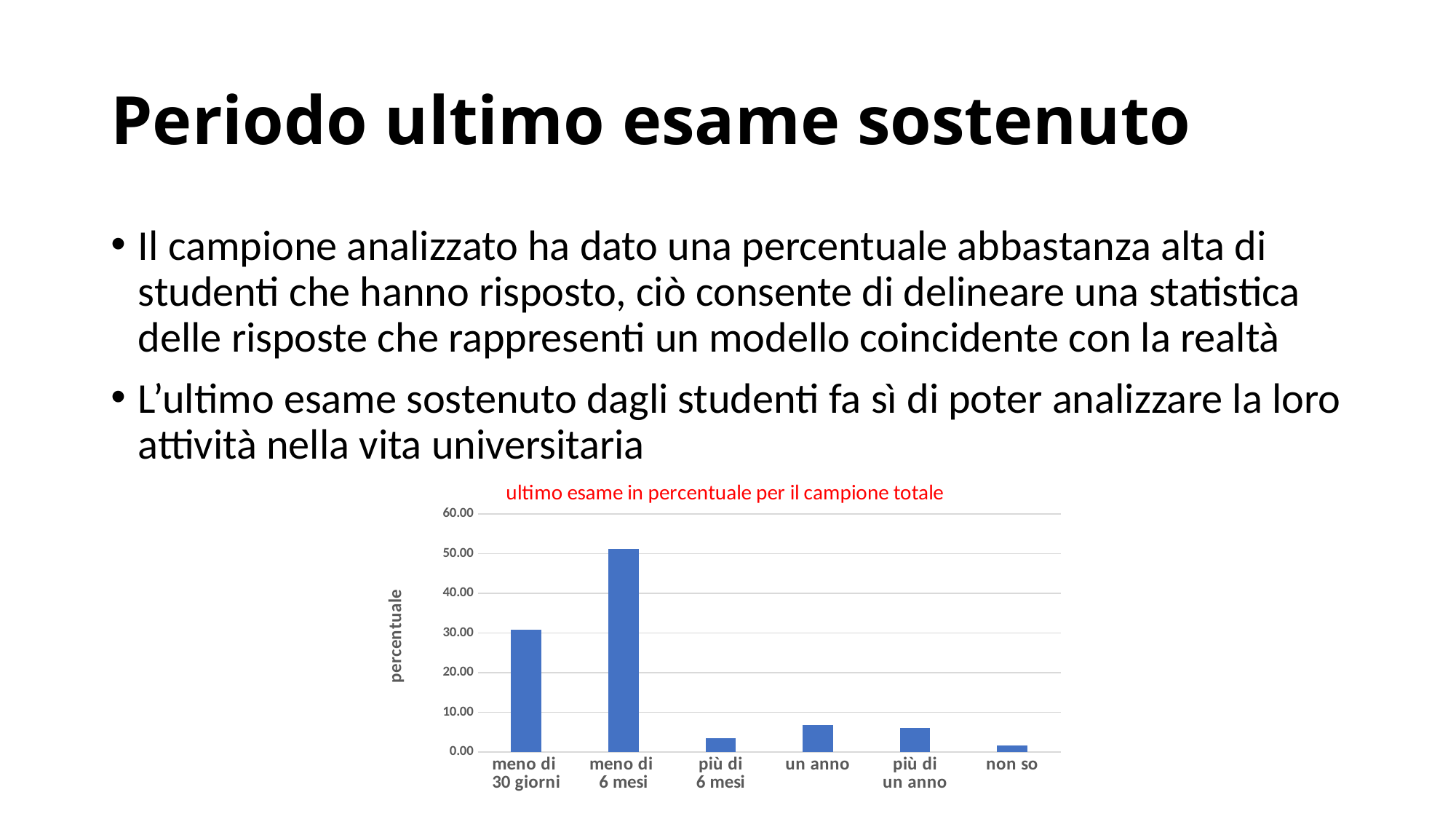
Which is larger, the value for 'più di 6 mesi' or the value for 'un anno'? un anno How many categories are shown on the x axis of the chart? 6 What is the label of the vertical axis of the chart? percentuale What is the title of the chart? ultimo esame in percentuale per il campione totale Is the value for 'meno di 6 mesi' greater or less than 50.00? greater Is the value for 'un anno' greater or less than 10.00? less Which is larger, the value for 'meno di 30 giorni' or the value for 'meno di 6 mesi'? meno di 6 mesi Is the value for 'più di 6 mesi' greater or less than 10.00? less Which category has the lowest value in the chart? non so Which category has the highest value in the chart? meno di 6 mesi What kind of chart is shown on the slide? bar chart